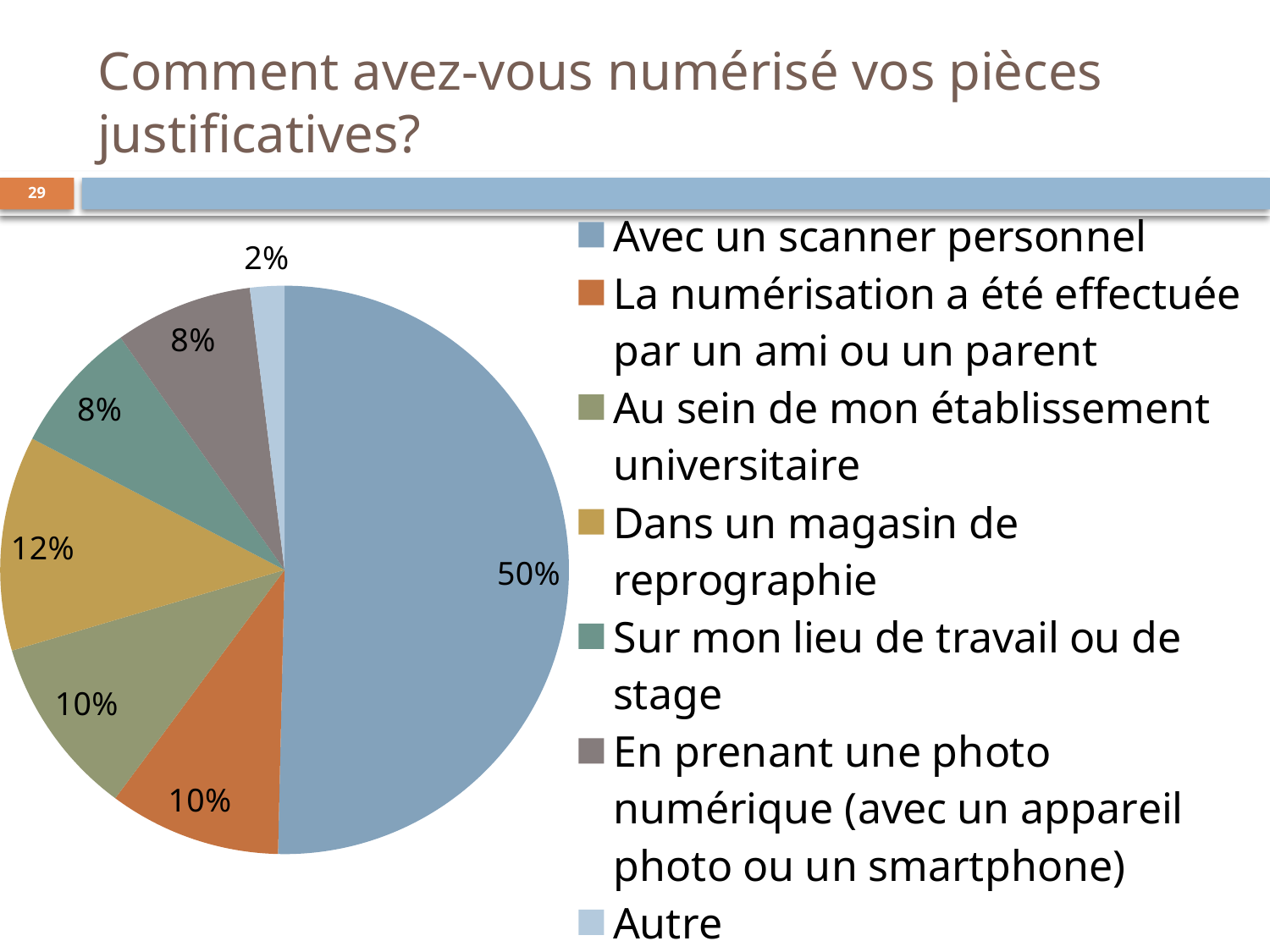
How many slices does the pie chart have? 7 Which is larger: the share for "Dans un magasin de reprographie" or the share for "En prenant une photo numérique (avec un appareil photo ou un smartphone)"? Dans un magasin de reprographie What share of the pie is "Autre"? 2% What share of the pie is "Avec un scanner personnel"? 50% What is the difference between the share for "Avec un scanner personnel" and the share for "Dans un magasin de reprographie"? 38% What share of the pie is "Sur mon lieu de travail ou de stage"? 8% What kind of chart is shown on the slide? pie chart Which category has the largest slice of the pie? Avec un scanner personnel What is the title of the slide containing the pie chart? Comment avez-vous numérisé vos pièces justificatives? Which category has the smallest slice of the pie? Autre